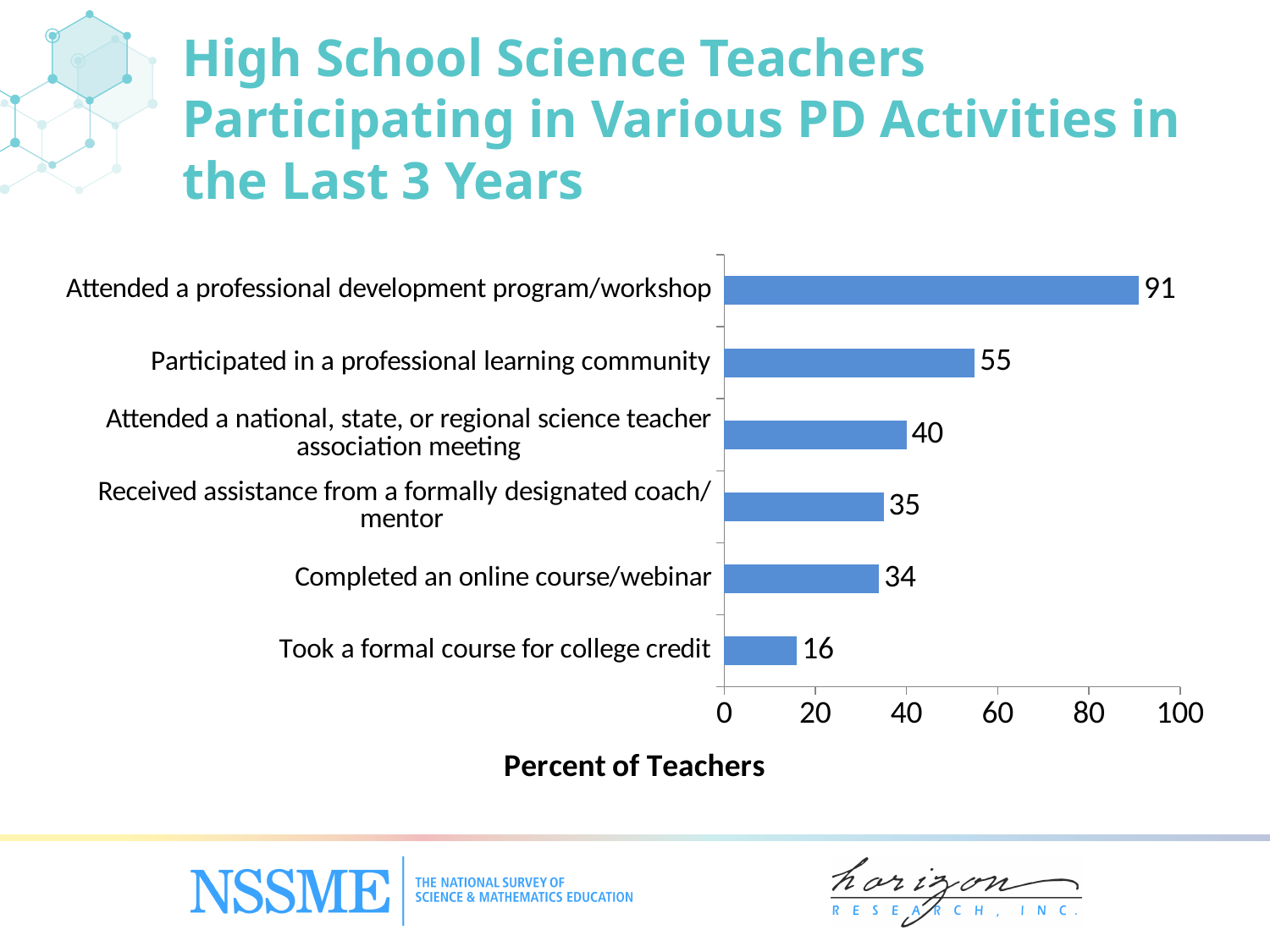
What kind of chart is shown on the slide? Bar chart What percent of teachers took a formal course for college credit? 16 How many PD activities are shown in the chart? 6 Which PD activity has the highest percent of teachers? Attended a professional development program/workshop Which is larger: the percent of teachers who attended a national, state, or regional science teacher association meeting or the percent who received assistance from a formally designated coach/mentor? Attended a national, state, or regional science teacher association meeting Is the percent of teachers who participated in a professional learning community greater or less than 60? less What percent of teachers attended a professional development program/workshop? 91 Which PD activity has the lowest percent of teachers? Took a formal course for college credit What is the label of the horizontal axis? Percent of Teachers What percent of teachers participated in a professional learning community? 55 What is the difference in percent of teachers between attending a professional development program/workshop and participating in a professional learning community? 36 What percent of teachers completed an online course/webinar? 34